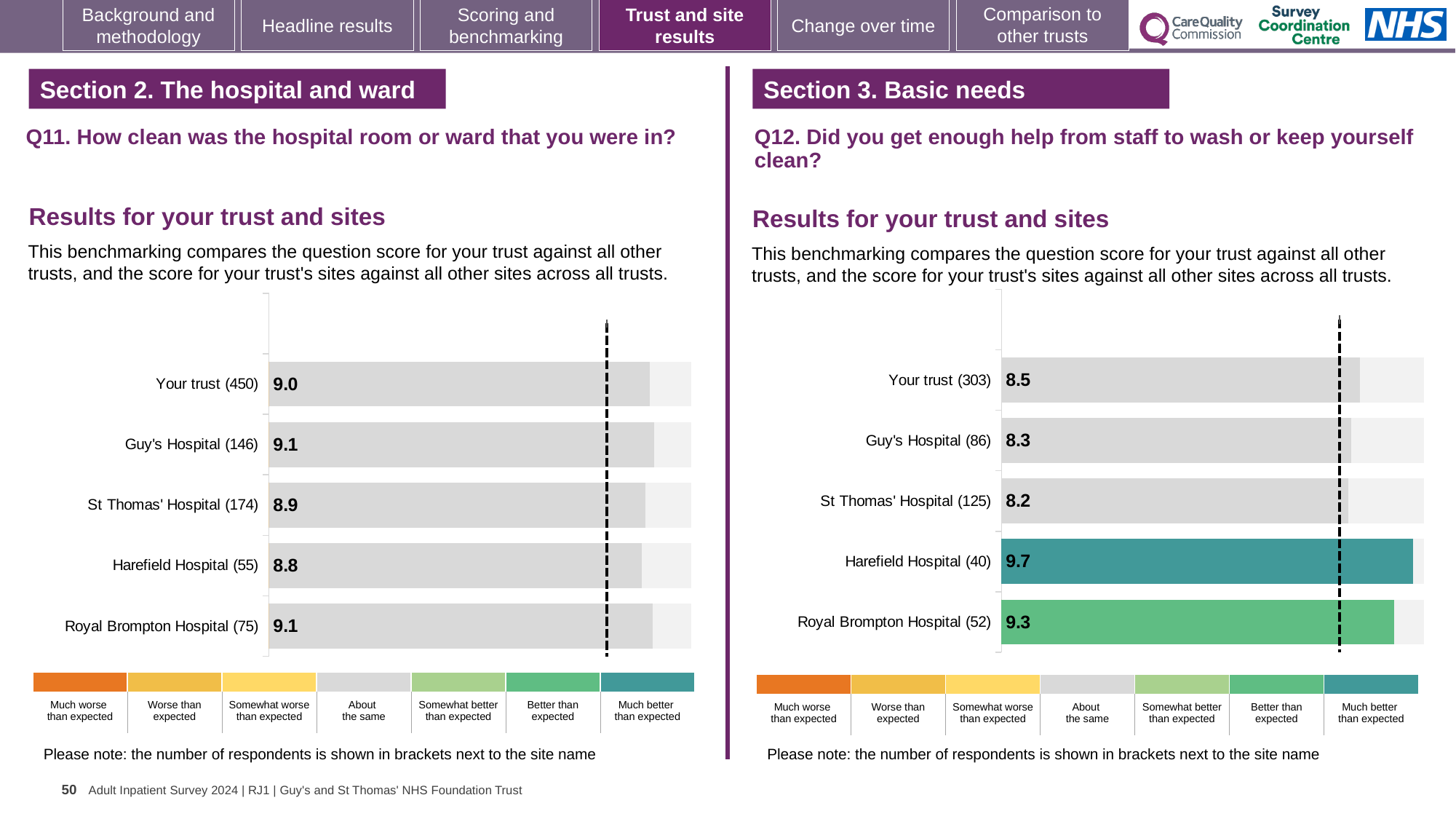
In the Q11 chart (left), what is the difference between the scores for Guy's Hospital and St Thomas' Hospital? 0.2 In the Q12 chart (right), which site has the lowest score? St Thomas' Hospital In the Q11 chart (left), how many bars are plotted? 5 In the Q12 chart (right), what is the difference between the scores for Harefield Hospital and Royal Brompton Hospital? 0.4 In the Q12 chart (right), what is the score for Harefield Hospital? 9.7 In the Q12 chart (right), which has the higher score, Guy's Hospital or Royal Brompton Hospital? Royal Brompton Hospital In the Q12 chart (right), what is the score for Your trust? 8.5 In the Q11 chart (left), what is the score for Harefield Hospital? 8.8 In the Q12 chart (right), which site has the highest score? Harefield Hospital In the Q11 chart (left), which site has the lowest score? Harefield Hospital In the Q11 chart (left), what is the score for Your trust? 9.0 What kind of chart is used for the Q11 results on the left? Bar chart